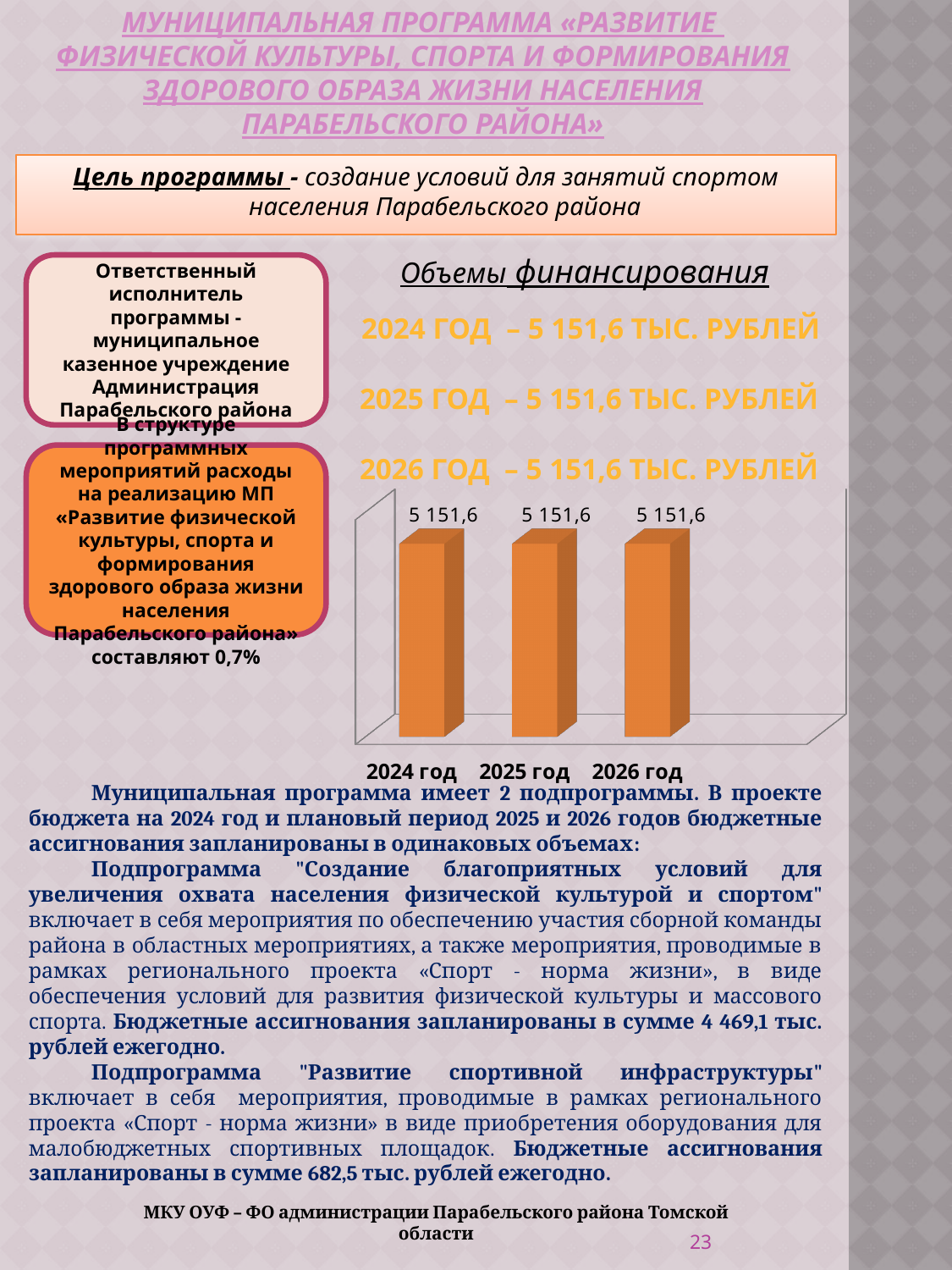
How many bars (categories) does the chart show? 3 What is the value shown for 2024 год? 5 151,6 Do the values rise, fall or stay the same from 2024 год to 2026 год? stay the same What is the difference between the values for 2025 год and 2024 год? 0 Which years are shown as categories on the chart's x axis? 2024 год, 2025 год, 2026 год What kind of chart is shown on the slide? bar chart What is the difference between the values for 2024 год and 2026 год? 0 What colour are the bars in the chart? orange What is the value shown for 2025 год? 5 151,6 What is the value shown for 2026 год? 5 151,6